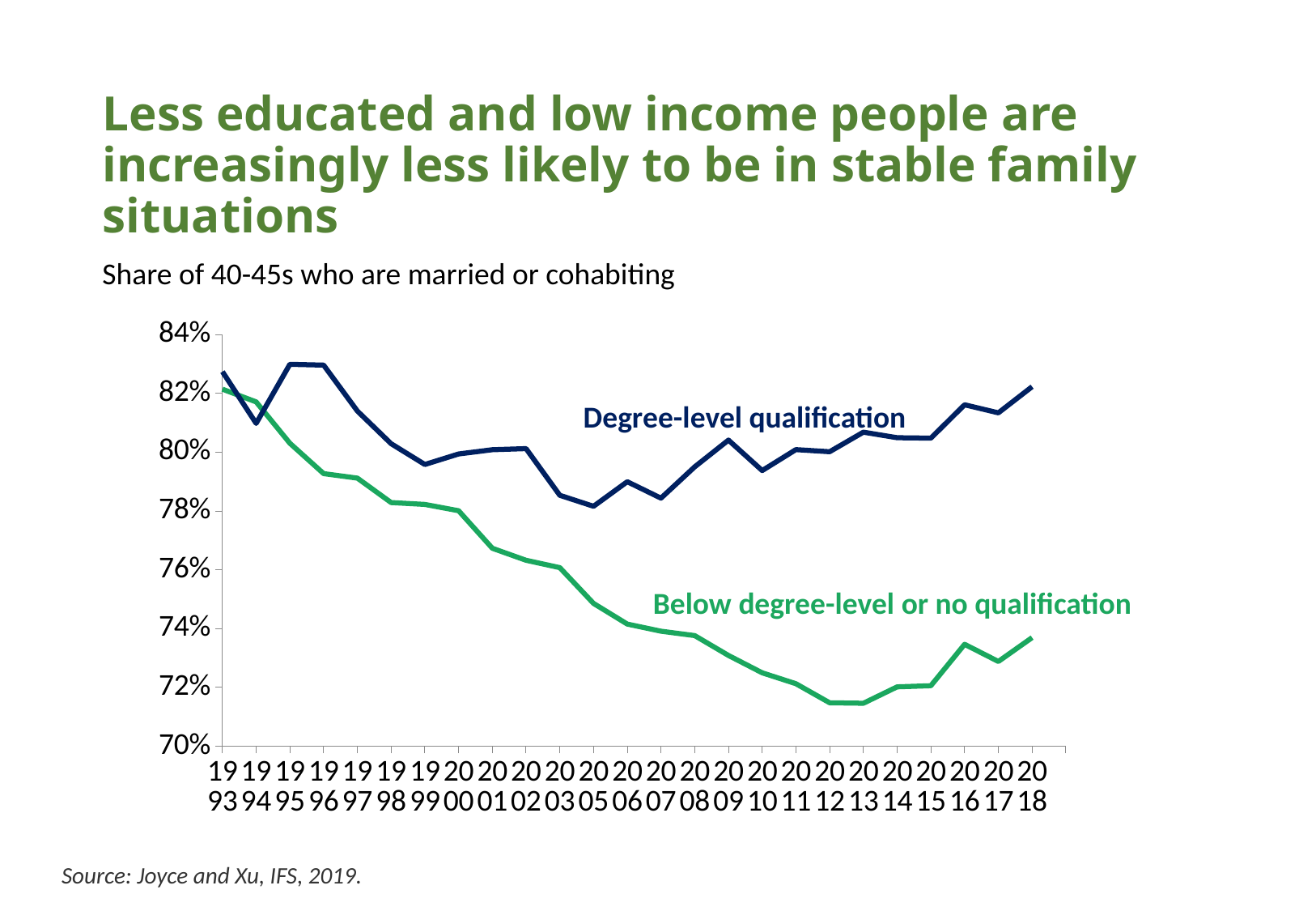
How many years are shown along the x axis of the chart? 25 Is the value for 'Degree-level qualification' in 2005 greater or less than 80%? less What kind of chart is shown on the slide? Line chart Is the value for 'Below degree-level or no qualification' in 2012 greater or less than 72%? less Is the value for 'Below degree-level or no qualification' in 1993 greater or less than 80%? greater In 2018, which series has the higher value: 'Degree-level qualification' or 'Below degree-level or no qualification'? Degree-level qualification How many series are plotted on the chart? 2 In which year is the 'Below degree-level or no qualification' series at its highest? 1993 Does the 'Below degree-level or no qualification' line rise or fall between 1993 and 2012? Fall What does the chart measure, according to the subtitle above it? Share of 40-45s who are married or cohabiting